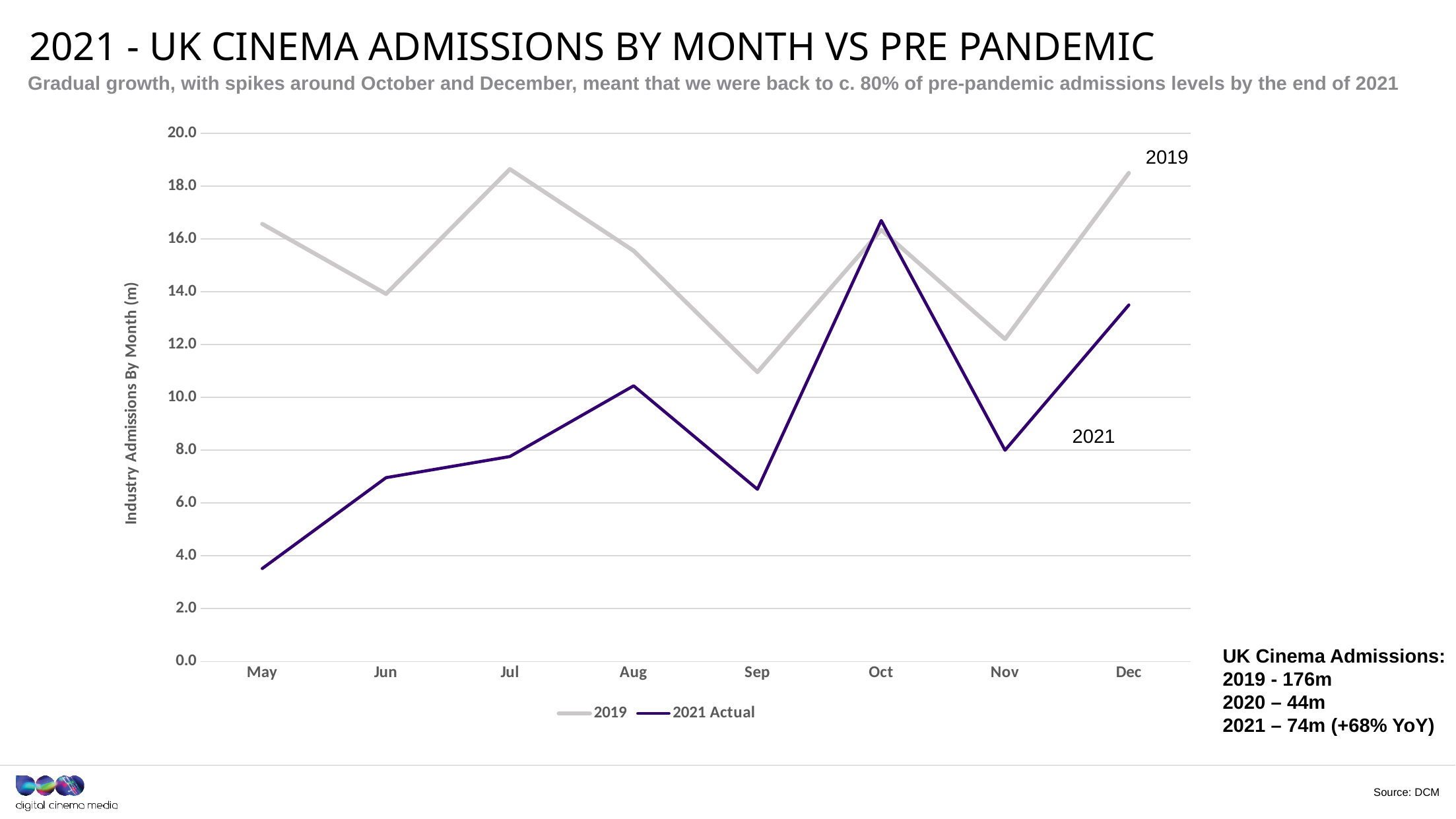
In which month is the 2019 series at its lowest? Sep What kind of chart is shown on the slide? Line chart For Sep, which series has the higher value, 2019 or 2021 Actual? 2019 In which month is the 2021 Actual series at its lowest? May Is the 2021 Actual value for May greater or less than 4.0? less Does the 2021 Actual series rise or fall from May to Aug? Rise Is the 2021 Actual value for Dec greater or less than 12.0? greater What is the title of the vertical axis? Industry Admissions By Month (m) How many months are plotted along the x axis? 8 How many series does the legend list? 2 Is the 2019 value for Jul greater or less than 18.0? greater In which month does the 2021 Actual series reach its highest value? Oct